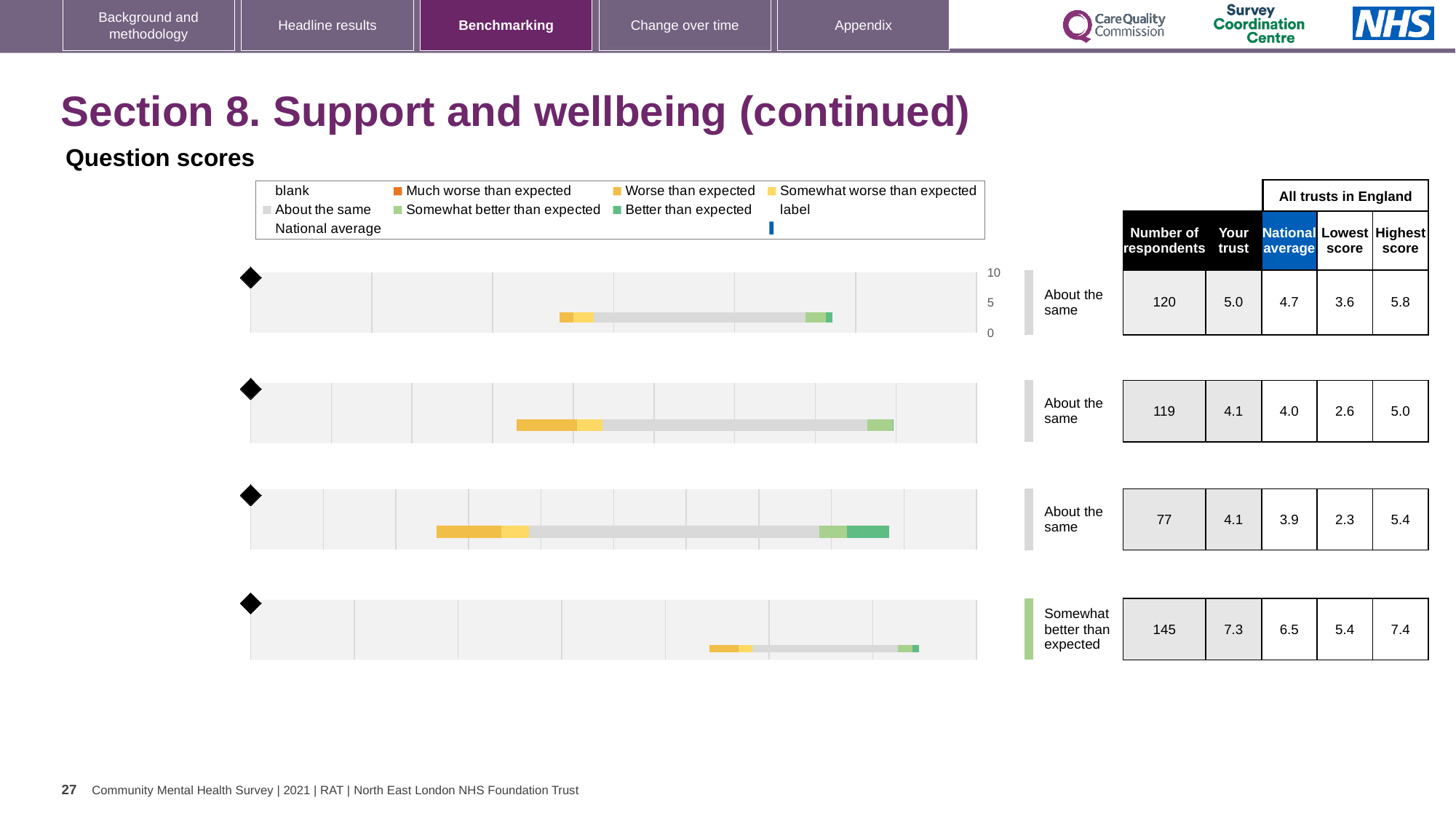
What benchmark category is given for the fourth (bottom) chart? Somewhat better than expected Which chart row has the highest 'Your trust' score? The fourth (bottom) row, 7.3 How many benchmarking bar charts are shown on the slide? 4 For the third chart, what is the lowest score among all trusts in England? 2.3 Which chart row has the lowest number of respondents? The third row, 77 For the second chart, what is the difference between the highest score and the lowest score among all trusts in England? 2.4 For the fourth (bottom) chart, what is the national average shown in the table? 6.5 What kind of chart is used for the question scores on this slide? Bar chart In the legend, what colour represents 'Better than expected'? Green For the first (top) chart, what is the 'Your trust' score shown in the table? 5.0 For the fourth (bottom) chart, what is the difference between the 'Your trust' score and the national average? 0.8 For the first (top) chart, which is larger: the 'Your trust' score or the national average? Your trust (5.0)